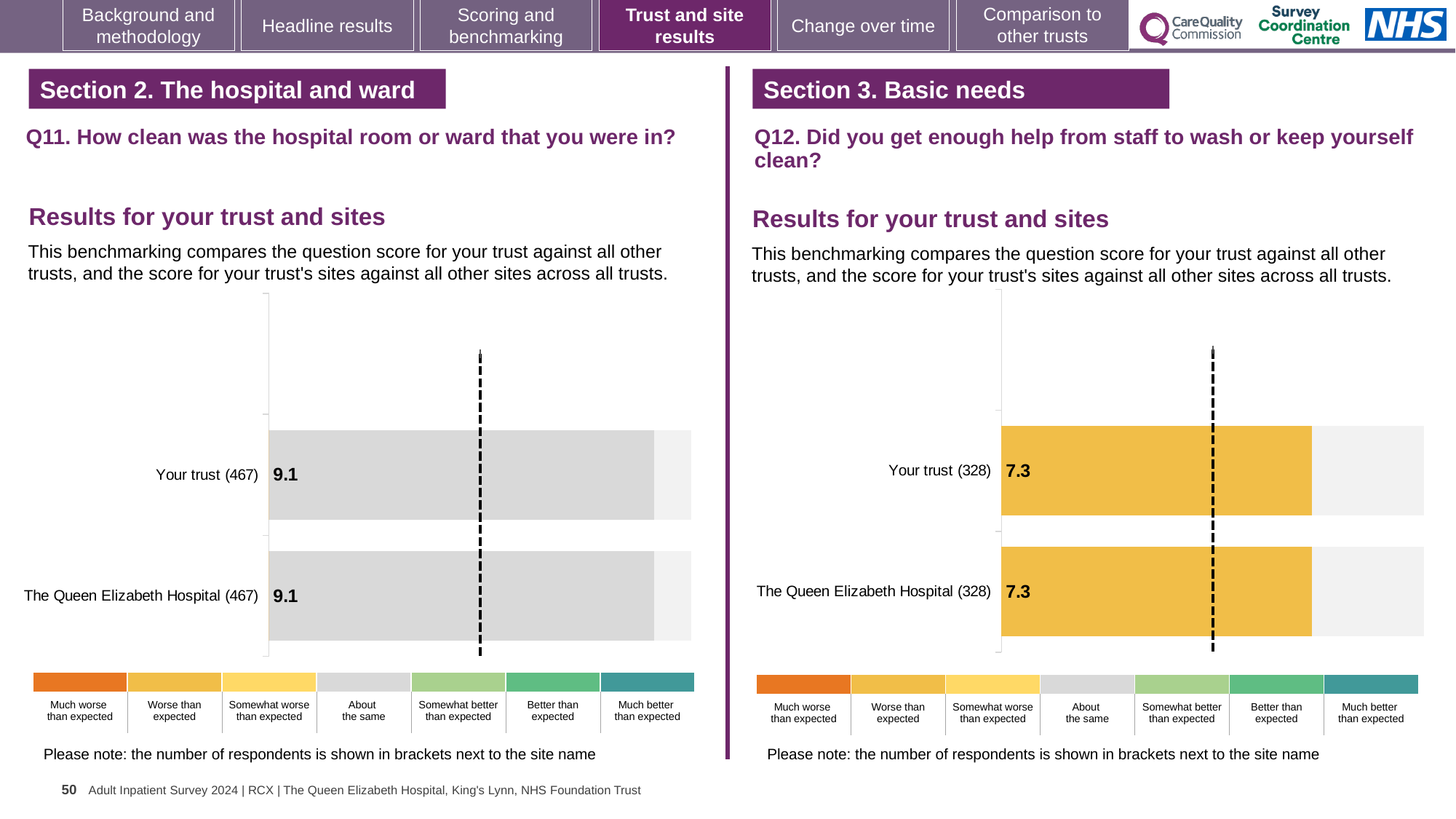
What type of chart is used for the Q11 results on the left? Bar chart In the Q12 chart on the right, what is the difference between the score for Your trust and the score for The Queen Elizabeth Hospital? 0.0 According to the colour key, which benchmark category does the yellow colour of the bars in the Q12 chart on the right represent? Worse than expected In the Q11 chart on the left, what is the score for The Queen Elizabeth Hospital? 9.1 In the Q11 chart on the left, what is the score for Your trust? 9.1 In the Q11 chart on the left, what is the difference between the score for Your trust and the score for The Queen Elizabeth Hospital? 0.0 In the Q12 chart on the right, what is the score for The Queen Elizabeth Hospital? 7.3 In the Q12 chart on the right, what is the score for Your trust? 7.3 In the Q12 chart on the right, how many respondents are shown in brackets for The Queen Elizabeth Hospital? 328 How many bars are plotted in the Q11 chart on the left? 2 How many bars are plotted in the Q12 chart on the right? 2 In the Q11 chart on the left, how many respondents are shown in brackets for Your trust? 467